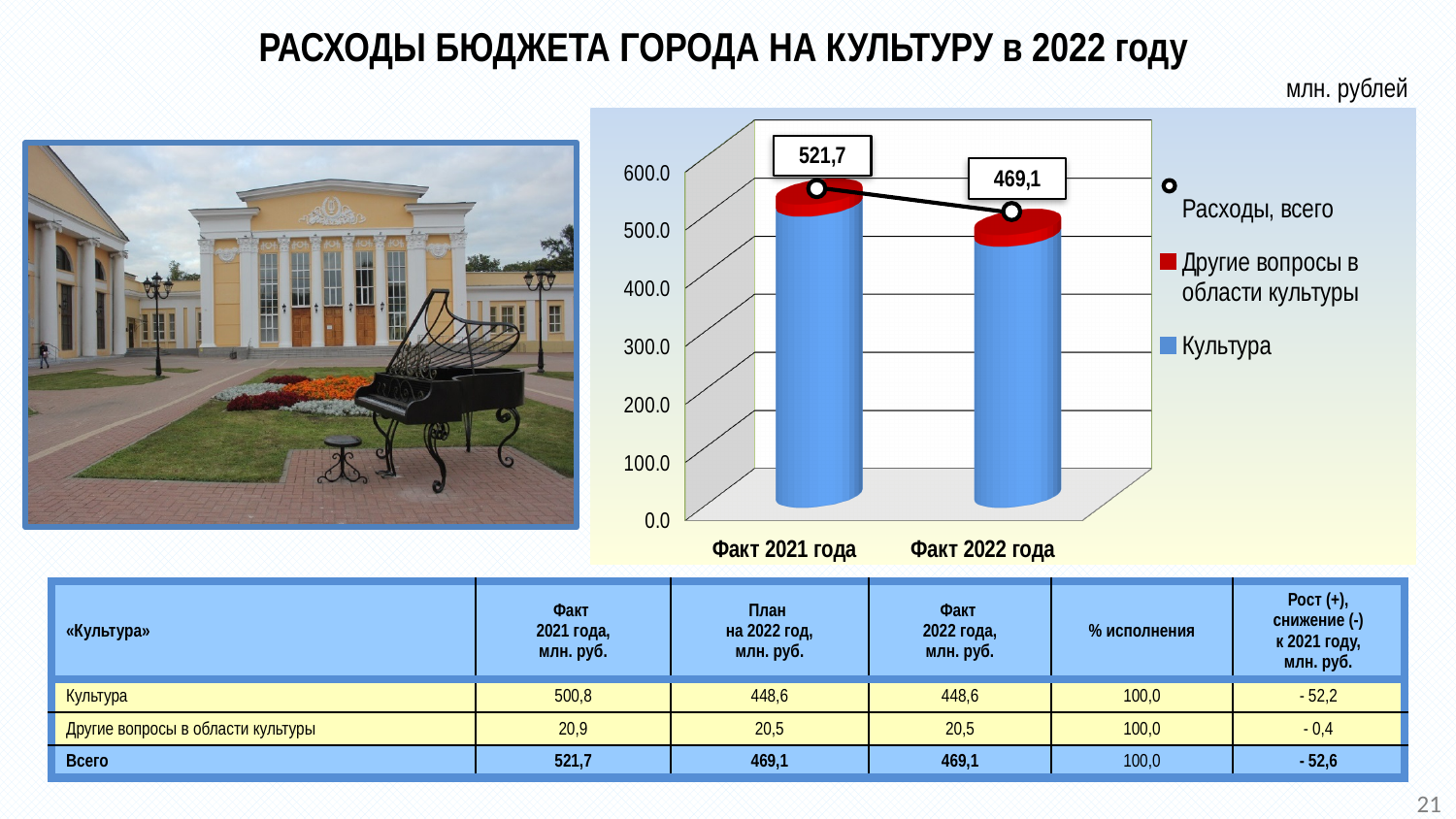
What is the value of the 'Расходы, всего' line for 'Факт 2021 года'? 521,7 How many series does the chart legend list? 3 What kind of chart is shown on the slide? stacked bar chart with a line Which category has the higher 'Расходы, всего' value, 'Факт 2021 года' or 'Факт 2022 года'? Факт 2021 года Does the 'Расходы, всего' line rise or fall from 'Факт 2021 года' to 'Факт 2022 года'? fall Is the 'Культура' bar for 'Факт 2021 года' greater or less than 400.0? greater Which legend entry is shown in red? Другие вопросы в области культуры How many categories are shown on the x axis of the chart? 2 Is the 'Культура' bar for 'Факт 2022 года' greater or less than 500.0? less What unit is stated for the chart values? млн. рублей What is the difference between the 'Расходы, всего' values for 'Факт 2021 года' and 'Факт 2022 года'? 52,6 What is the value of the 'Расходы, всего' line for 'Факт 2022 года'? 469,1